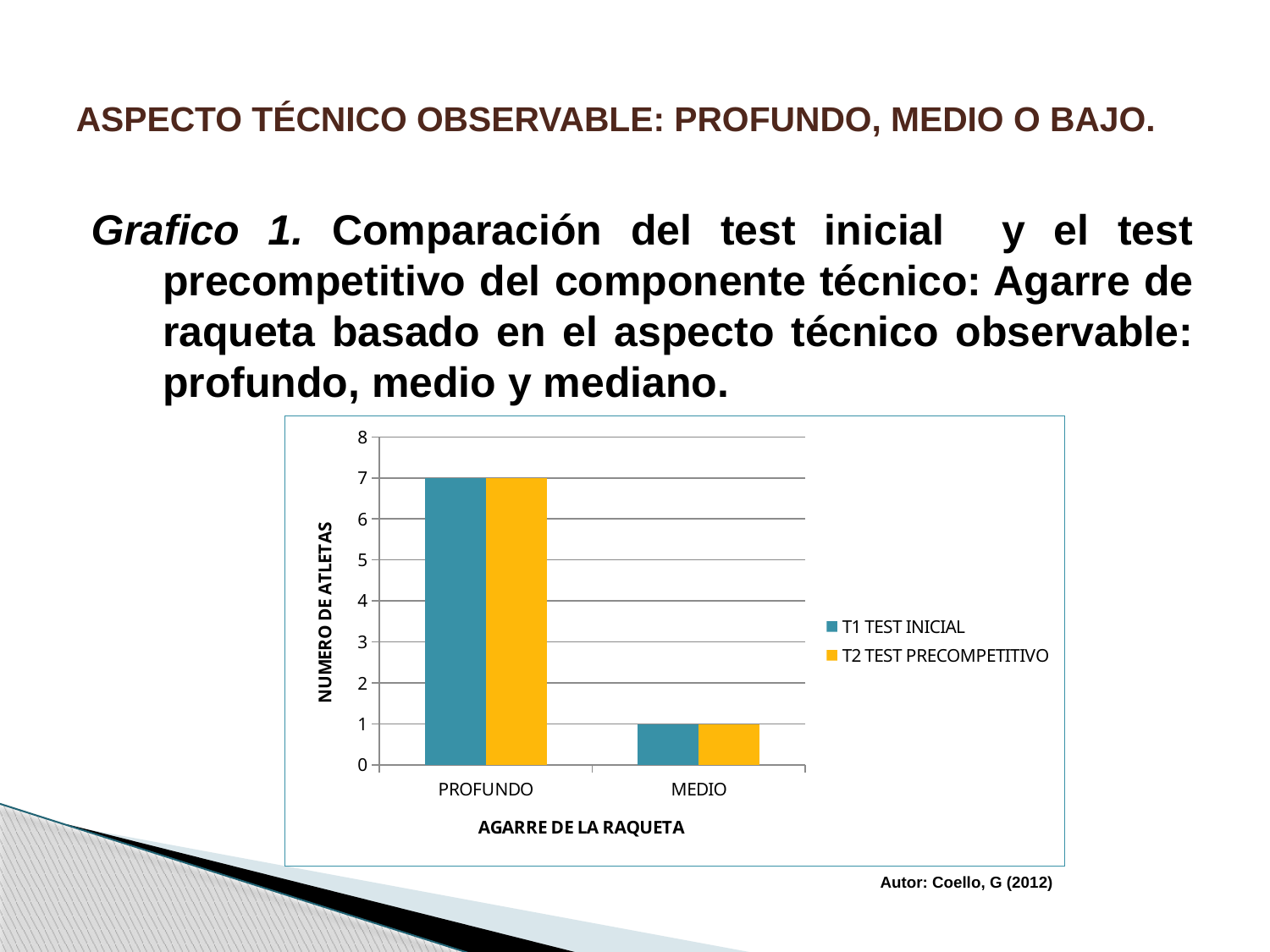
How many series does the legend list? 2 What is the value for PROFUNDO in the T1 TEST INICIAL series? 7 What is the title of the y axis? NUMERO DE ATLETAS What is the value for PROFUNDO in the T2 TEST PRECOMPETITIVO series? 7 How many categories are shown on the x axis? 2 What is the value for MEDIO in the T1 TEST INICIAL series? 1 Which category has the lowest value in the T2 TEST PRECOMPETITIVO series? MEDIO What kind of chart is shown on the slide? bar chart Which category has the highest value in the T1 TEST INICIAL series? PROFUNDO What is the difference between the T1 TEST INICIAL values for PROFUNDO and MEDIO? 6 What is the value for MEDIO in the T2 TEST PRECOMPETITIVO series? 1 Is the T2 TEST PRECOMPETITIVO value for PROFUNDO greater or less than 4? greater